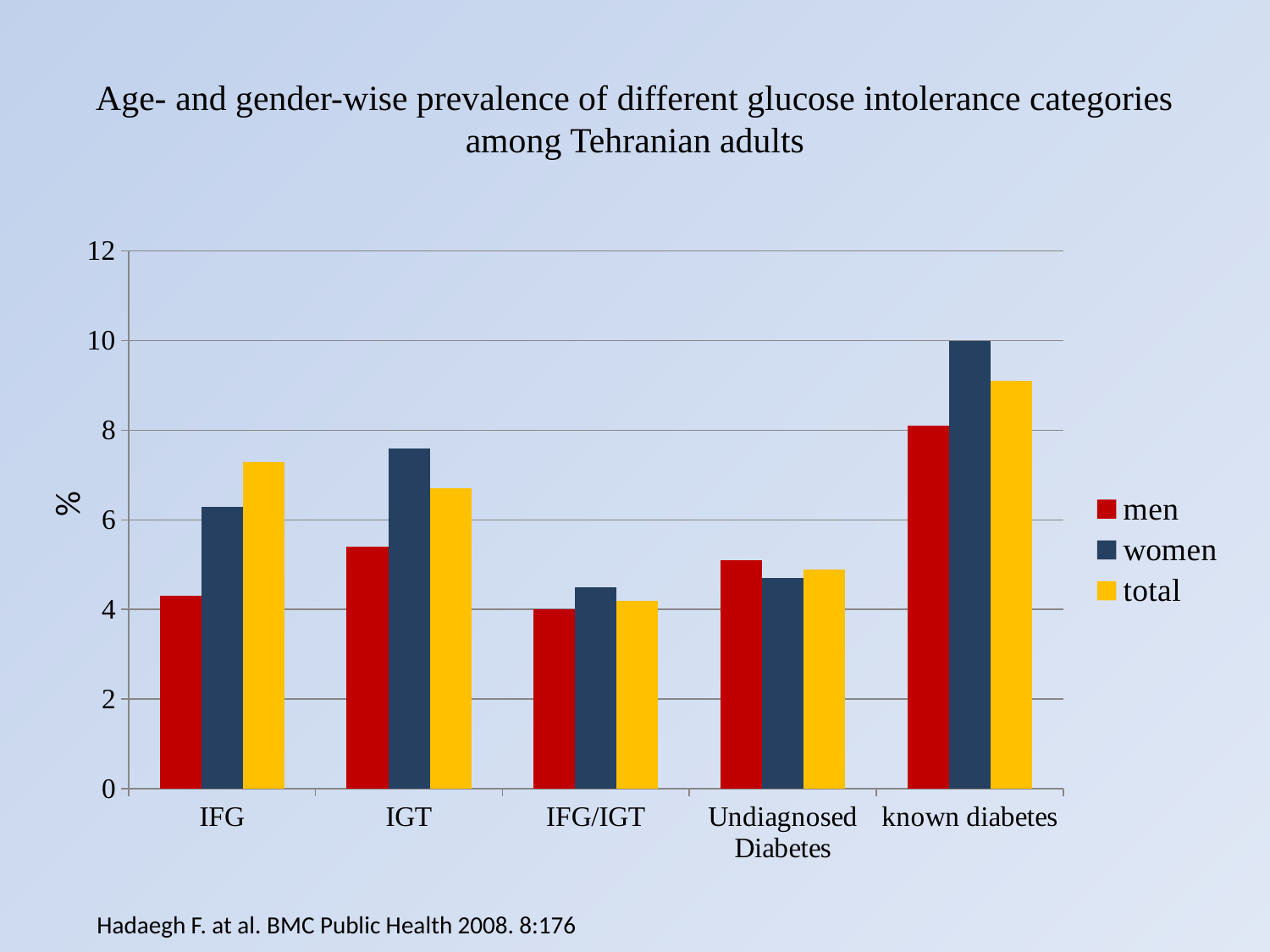
Is the value for total in the known diabetes category greater or less than 8? greater How many series does the legend list? 3 Which category has the lowest value for men? IFG/IGT Which category has the highest value for women? known diabetes What is the value for women in the known diabetes category? 10 What label is shown on the y axis? % In the Undiagnosed Diabetes category, which is larger, the value for men or the value for women? men How many glucose intolerance categories are shown on the x axis? 5 What kind of chart is shown on the slide? bar chart What is the value for men in the IFG/IGT category? 4 In the IGT category, which is larger, the value for men or the value for women? women Is the value for total in the IFG category greater or less than 6? greater